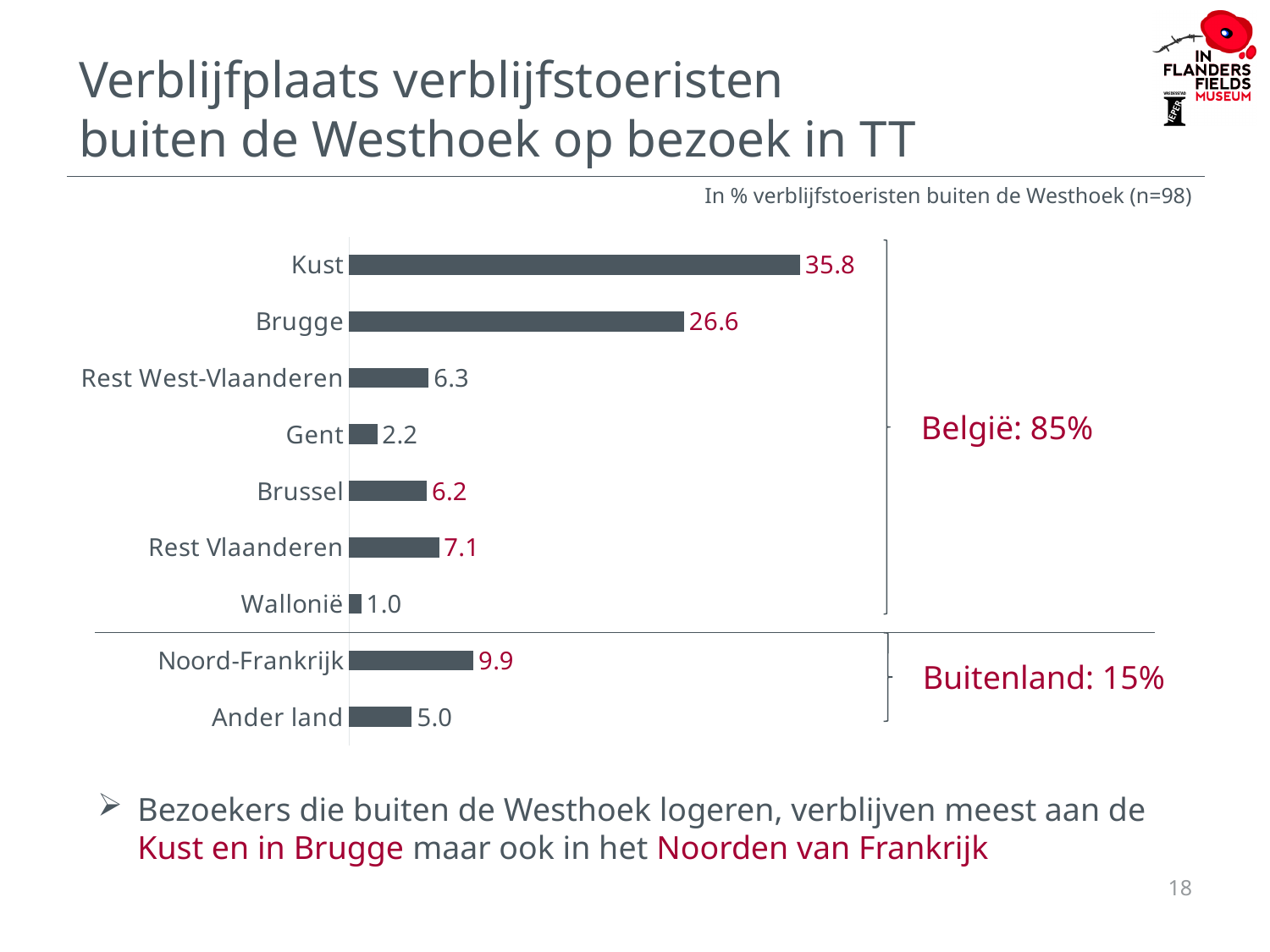
What is the value for Noord-Frankrijk? 9.9 Which is larger, the value for Rest Vlaanderen or the value for Rest West-Vlaanderen? Rest Vlaanderen Which category has the lowest value? Wallonië What is the difference between the values for Noord-Frankrijk and Ander land? 4.9 What is the difference between the values for Kust and Brugge? 9.2 What is the value for Wallonië? 1.0 How many categories are shown in the chart? 9 What kind of chart is shown on the slide? Bar chart What is the value for Kust? 35.8 What is the value for Brugge? 26.6 What percentage is given for België on the slide? 85% Which category has the highest value? Kust